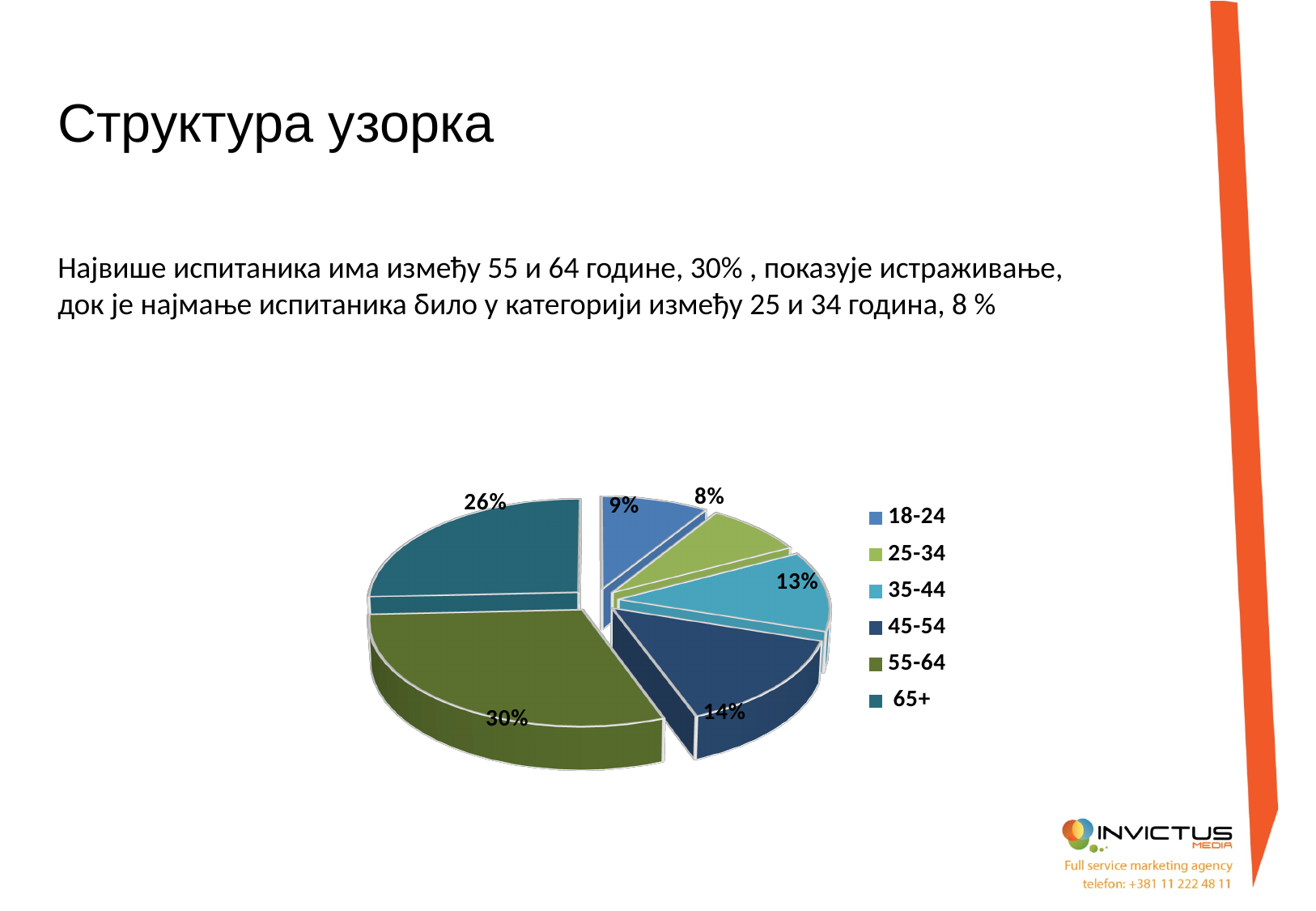
Which age group has the largest share of the pie? 55-64 What is the value for the 18-24 age group? 9% Which age group has the smallest share of the pie? 25-34 What is the value for the 65+ age group? 26% What share of the pie does the 55-64 age group have? 30% What share of the pie does the 25-34 age group have? 8% What kind of chart is shown on the slide? pie chart What is the difference between the shares of the 55-64 and 65+ age groups? 4% How many age groups are shown in the pie chart? 6 What is the value for the 35-44 age group? 13% What is the title of the slide containing the pie chart? Структура узорка Which is larger, the share for 45-54 or the share for 35-44? 45-54